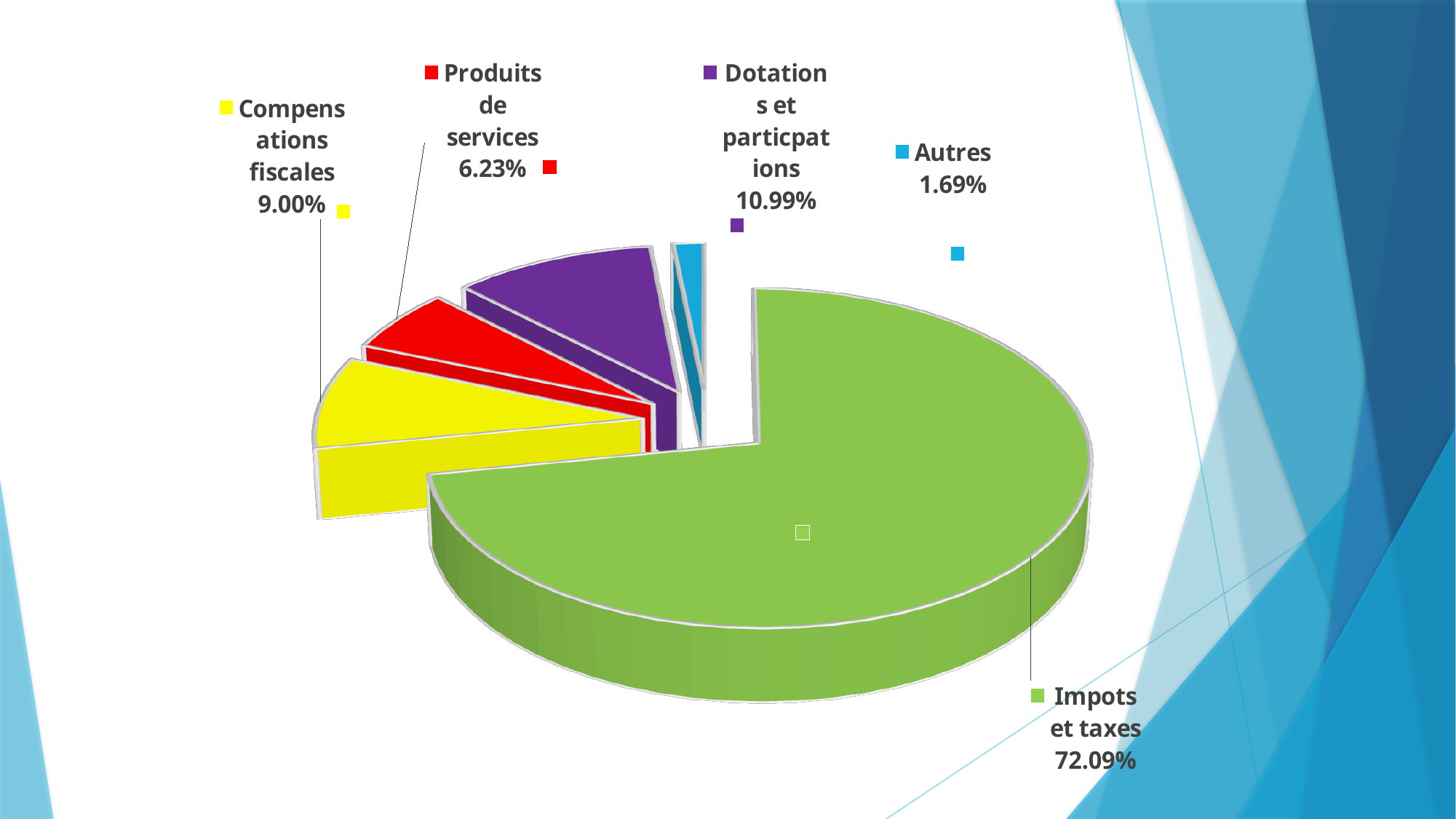
Which category has the smallest slice of the pie? Autres What share of the pie does Impots et taxes represent? 72.09% What share of the pie does Autres represent? 1.69% Which category has the largest slice of the pie? Impots et taxes What is the difference in percentage points between Impots et taxes and Dotations et participations? 61.10 What colour is the slice for Impots et taxes? green How many slices does the pie chart have? 5 What share of the pie does Compensations fiscales represent? 9.00% Which is larger, Compensations fiscales or Produits de services? Compensations fiscales What share of the pie does Produits de services represent? 6.23% What kind of chart is shown on the slide? pie chart What share of the pie does Dotations et participations represent? 10.99%